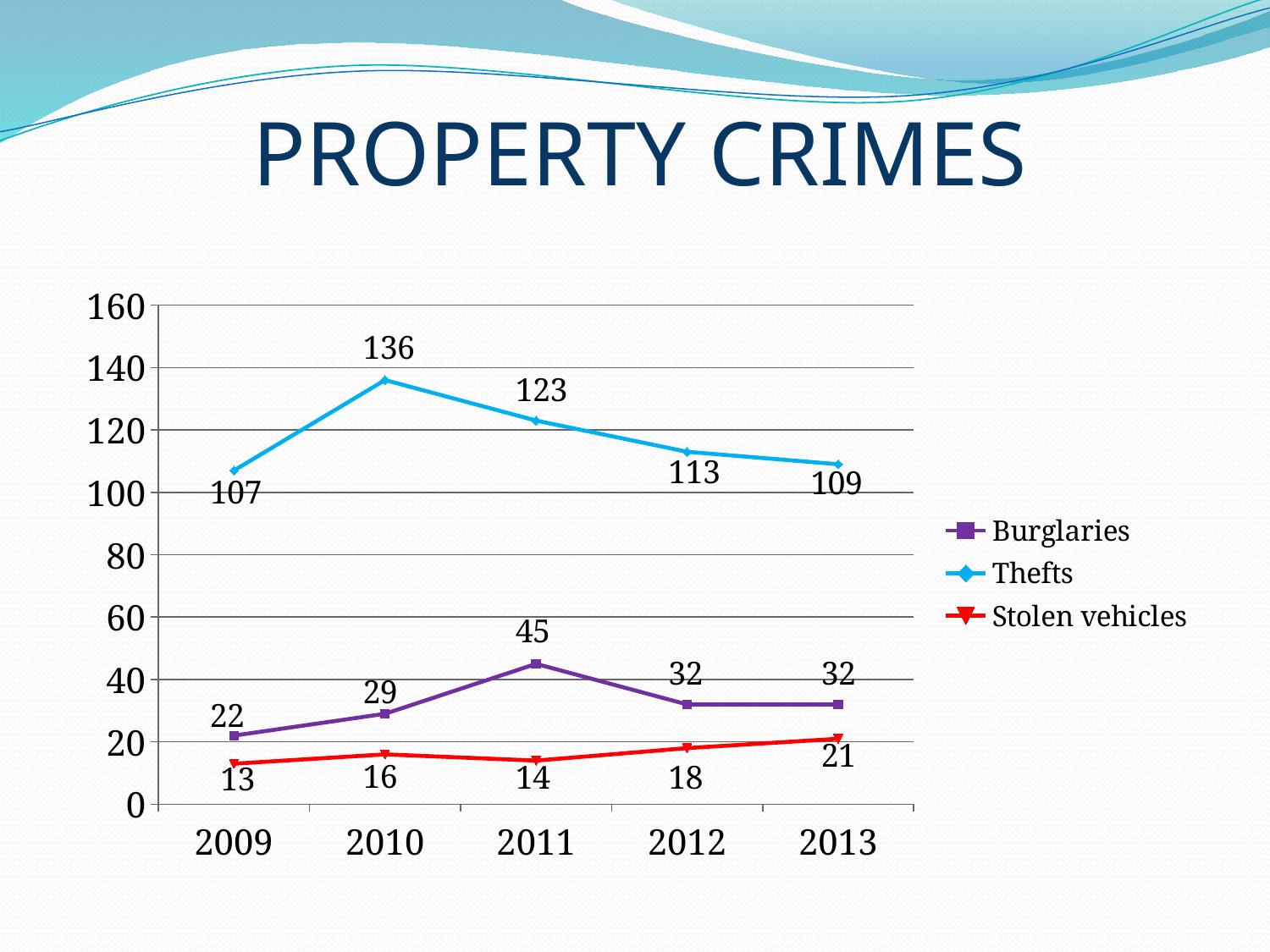
How many series does the legend list? 3 What kind of chart is shown on the slide? Line chart In which year were Stolen vehicles lowest? 2009 Which was larger in 2012, Burglaries or Stolen vehicles? Burglaries What is the difference between Thefts in 2010 and Thefts in 2013? 27 What was the number of Thefts in 2010? 136 What was the number of Burglaries in 2011? 45 What is the title of the slide? PROPERTY CRIMES In which year were Thefts highest? 2010 What was the number of Stolen vehicles in 2013? 21 Did Thefts rise or fall from 2010 to 2013? Fall How many years are shown on the x axis? 5